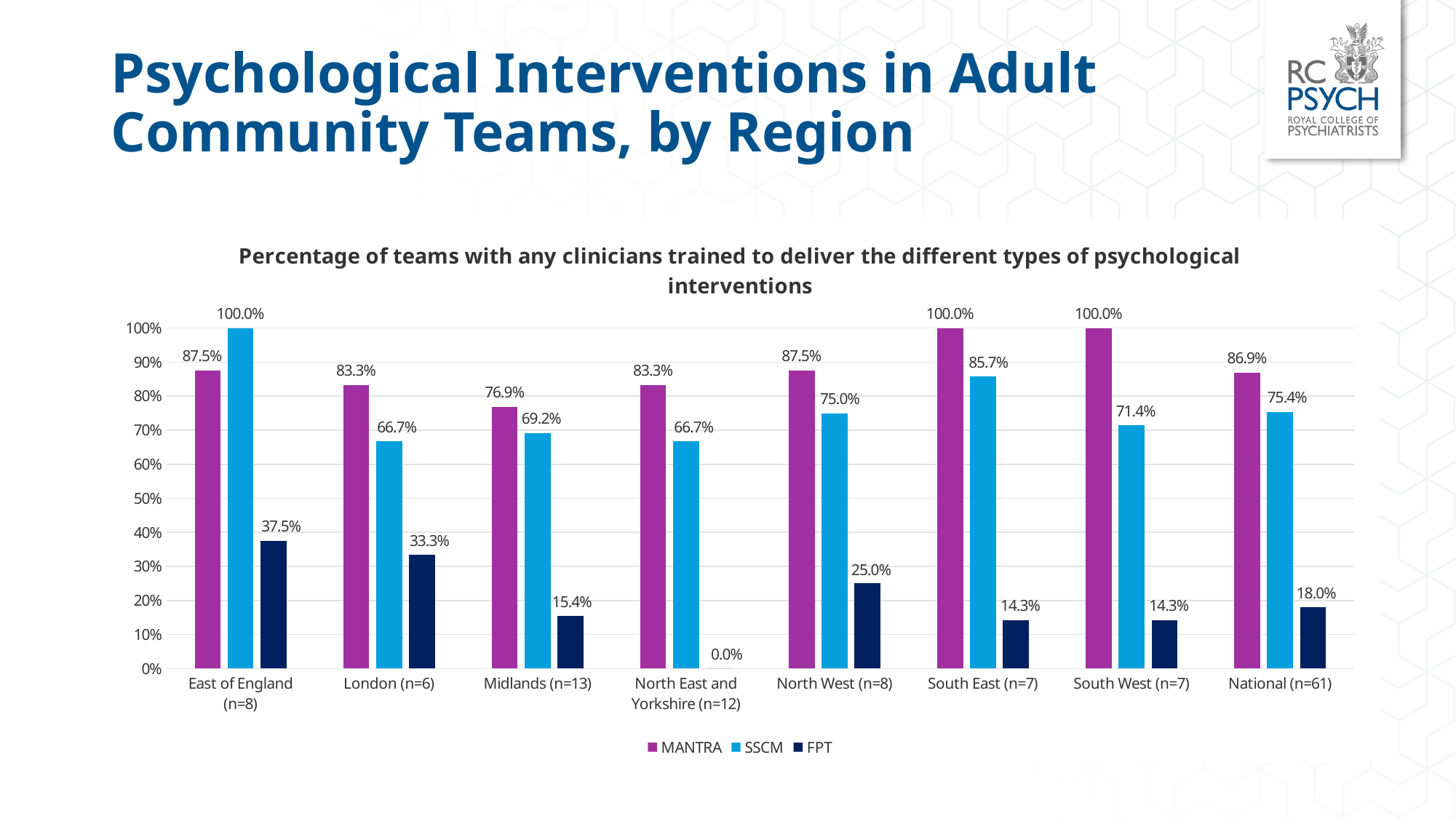
What is the MANTRA value for East of England (n=8)? 87.5% What is the SSCM value for South West (n=7)? 71.4% What is the FPT value for North East and Yorkshire (n=12)? 0.0% Which region has the lowest MANTRA value? Midlands (n=13) Which region has the highest FPT value? East of England (n=8) How many series does the legend list? 3 Which is larger, the SSCM value for North West (n=8) or the SSCM value for Midlands (n=13)? North West (n=8) What kind of chart is shown on the slide? Bar chart Which series is shown in dark navy in the legend? FPT What is the FPT value for National (n=61)? 18.0% What is the difference between the MANTRA and SSCM values for London (n=6)? 16.6% How many regions (categories) are shown on the x axis? 8